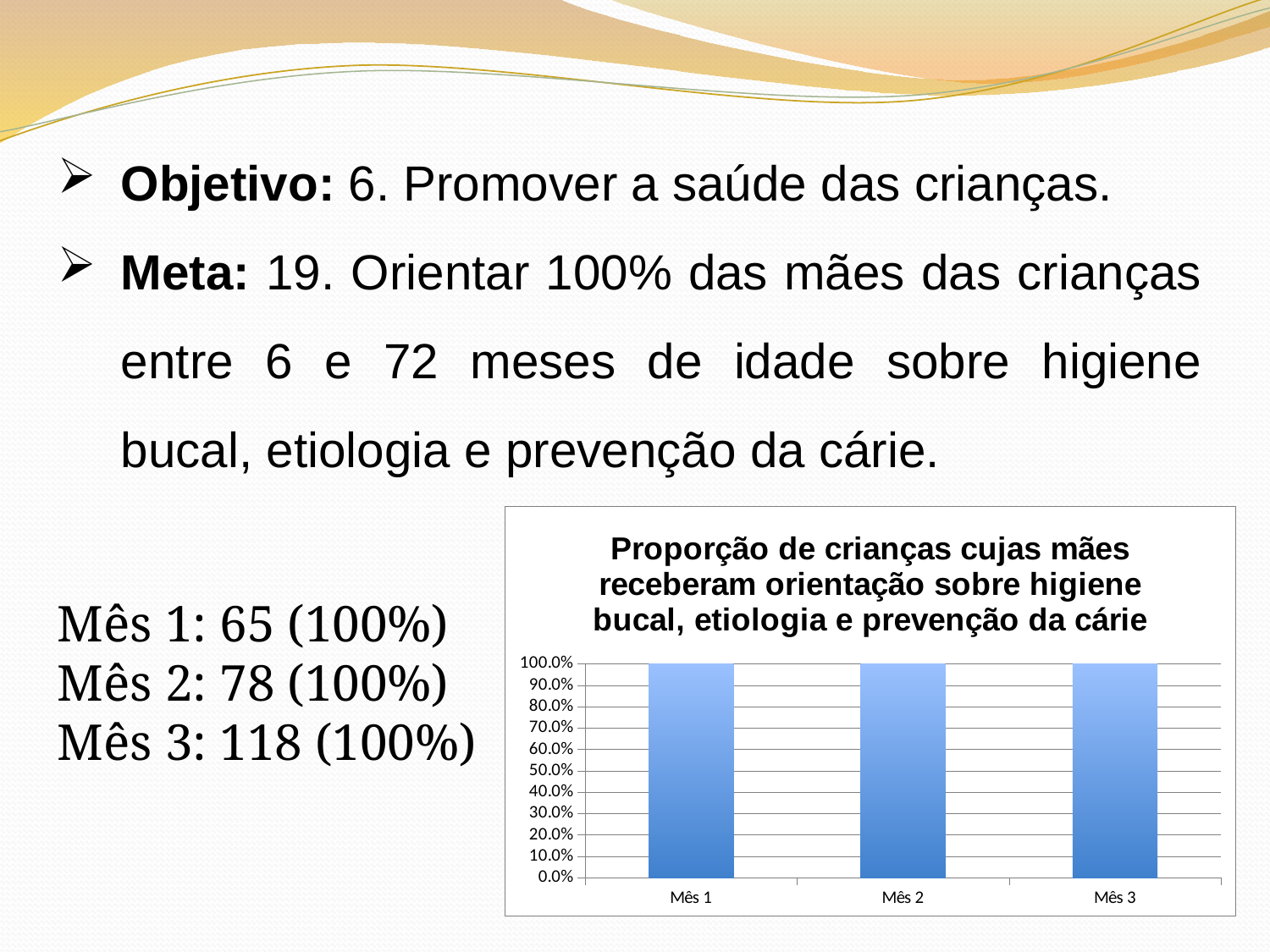
Is the value for Mês 3 greater or less than 90.0%? greater What is the value for Mês 2 on the chart? 100.0% What is the label of the first category on the x axis? Mês 1 Is the value for Mês 2 greater or less than 50.0%? greater Do the values rise, fall, or stay the same from Mês 1 to Mês 3? stay the same How many categories (months) are plotted on the chart? 3 What kind of chart is shown on the slide? bar chart What is the value for Mês 3 on the chart? 100.0% What is the difference between the values for Mês 1 and Mês 3? 0.0% What is the value for Mês 1 on the chart? 100.0% What is the title of the chart? Proporção de crianças cujas mães receberam orientação sobre higiene bucal, etiologia e prevenção da cárie